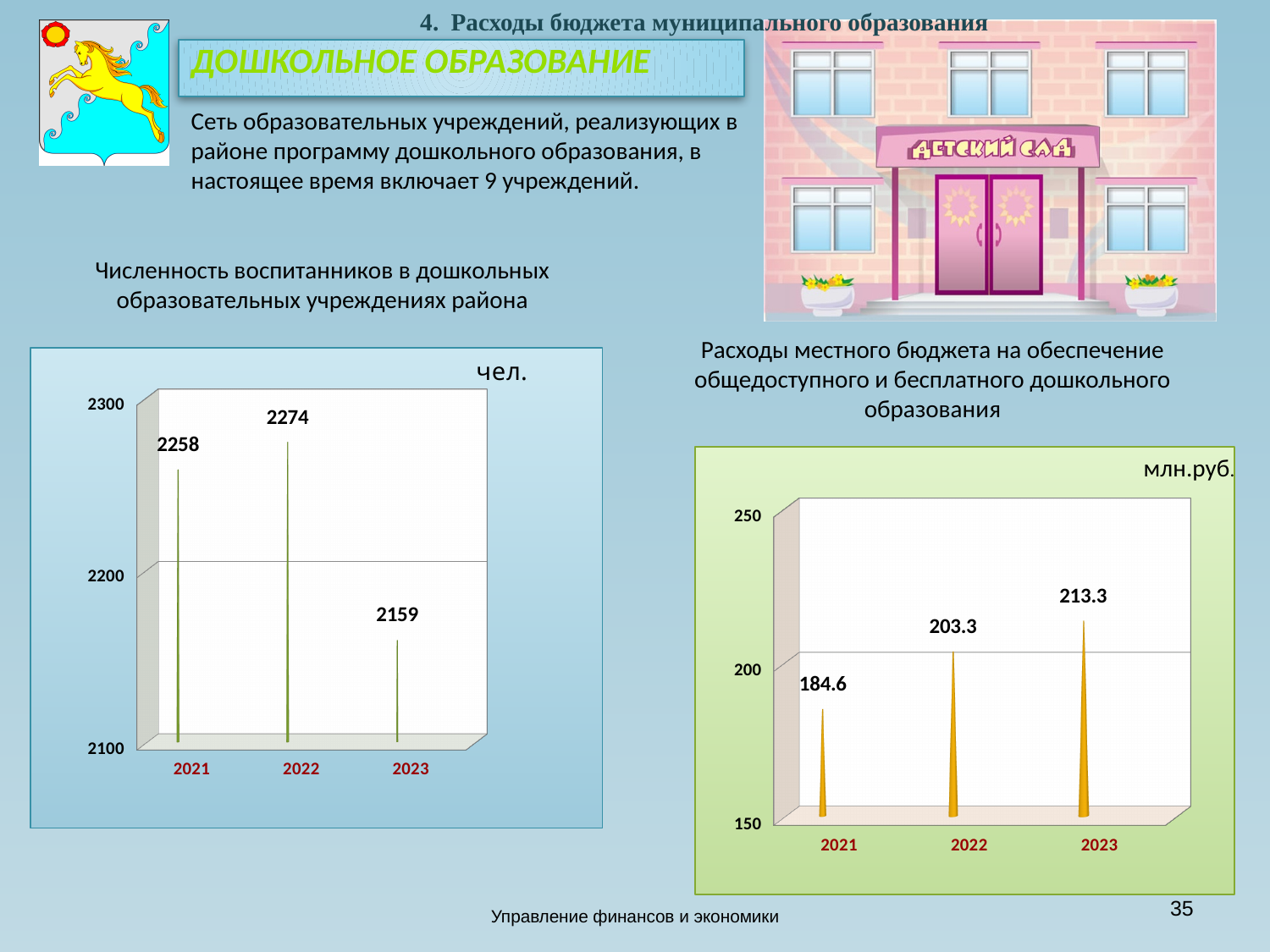
In the chart 'Численность воспитанников в дошкольных образовательных учреждениях района', what is the difference between the values for 2022 and 2023? 115 In the chart 'Численность воспитанников в дошкольных образовательных учреждениях района', what is the value for 2022? 2274 In the chart 'Расходы местного бюджета на обеспечение общедоступного и бесплатного дошкольного образования', do the values rise or fall from 2021 to 2023? rise In the chart 'Расходы местного бюджета на обеспечение общедоступного и бесплатного дошкольного образования', what is the value for 2023? 213.3 In the chart 'Расходы местного бюджета на обеспечение общедоступного и бесплатного дошкольного образования', is the value for 2021 greater or less than 200? less What unit is shown in the top right corner of the chart 'Расходы местного бюджета на обеспечение общедоступного и бесплатного дошкольного образования'? млн.руб. In the chart 'Расходы местного бюджета на обеспечение общедоступного и бесплатного дошкольного образования', which year has the highest value? 2023 In the chart 'Численность воспитанников в дошкольных образовательных учреждениях района', which year has the lowest value? 2023 In the chart 'Численность воспитанников в дошкольных образовательных учреждениях района', which year has the highest value? 2022 In the chart 'Расходы местного бюджета на обеспечение общедоступного и бесплатного дошкольного образования', what is the value for 2021? 184.6 In the chart 'Численность воспитанников в дошкольных образовательных учреждениях района', how many years are shown on the x axis? 3 In the chart 'Расходы местного бюджета на обеспечение общедоступного и бесплатного дошкольного образования', what is the difference between the values for 2023 and 2021? 28.7